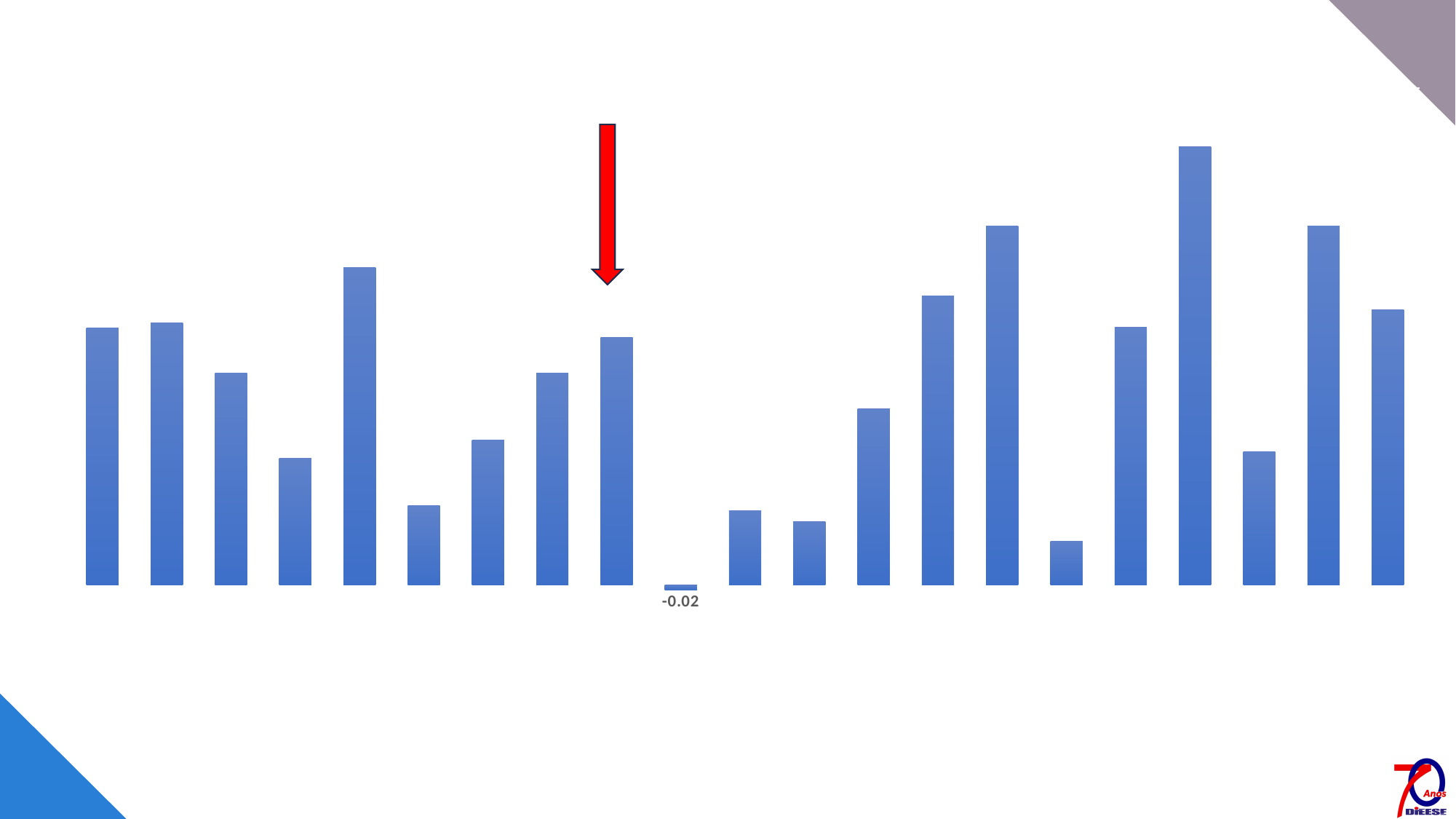
Counting from the left, which bar does the red arrow point to? the 9th bar Is the bar with the printed data label greater or less than 0? less Counting from the left, which bar is the tallest in the chart? the 18th bar What kind of chart is shown on the slide? bar chart What colour are the bars in the chart? blue How many bars are plotted in the chart? 21 Counting from the left, which bar is the lowest in the chart? the 10th bar How many bars in the chart have a negative value? 1 What is the value of the bar that extends below the baseline? -0.02 What is the only data label printed on the chart? -0.02